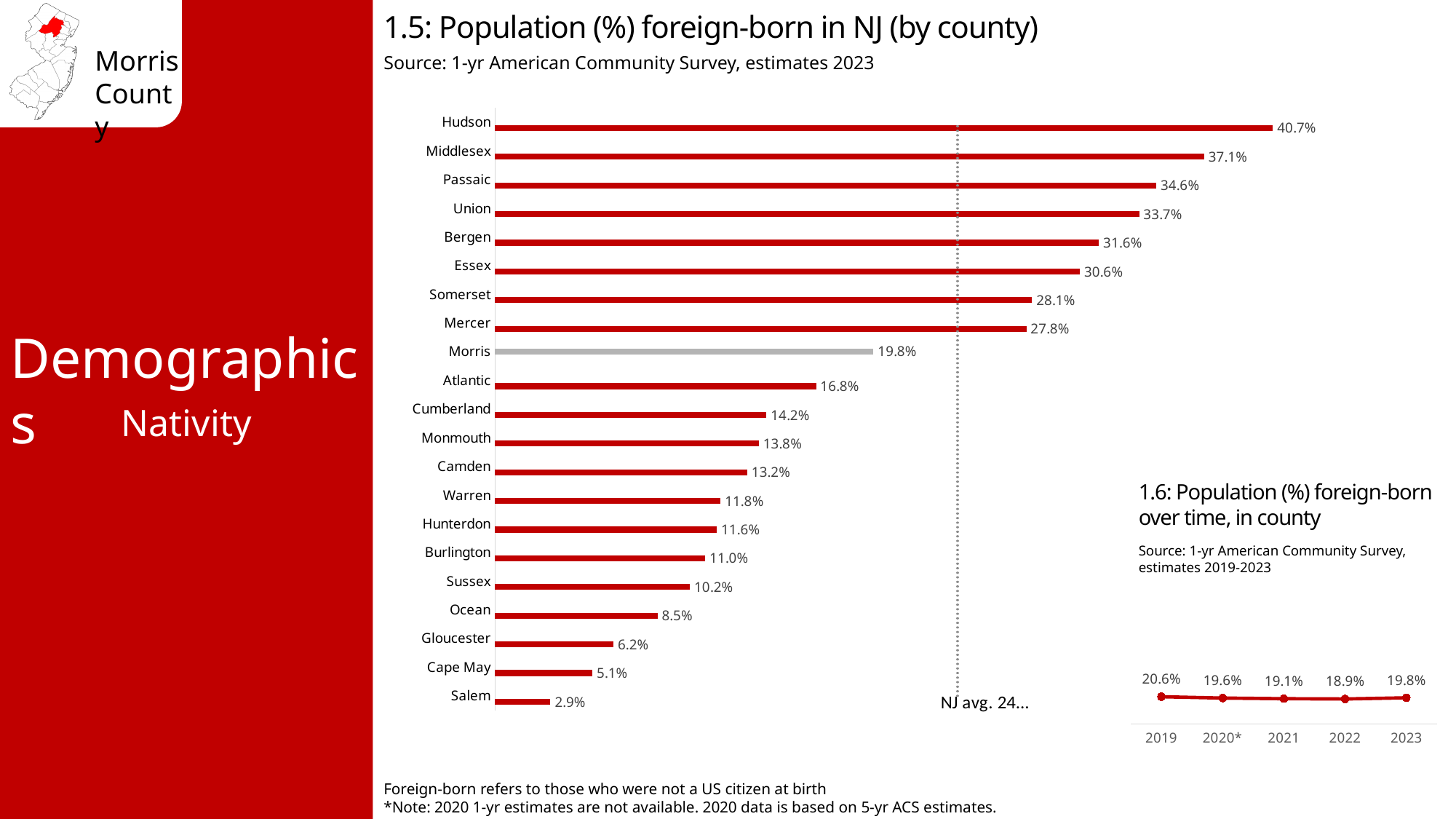
In chart 1.5 (Population (%) foreign-born in NJ by county), how many counties are shown? 21 In chart 1.5 (Population (%) foreign-born in NJ by county), what is the value for Cape May? 5.1% In chart 1.6 (Population (%) foreign-born over time, in county), what is the difference between 2019 and 2022? 1.7% In chart 1.5 (Population (%) foreign-born in NJ by county), what is the value for Morris? 19.8% In chart 1.6 (Population (%) foreign-born over time, in county), what is the value for 2021? 19.1% In chart 1.5 (Population (%) foreign-born in NJ by county), which county has the highest value? Hudson What kind of chart is chart 1.5 (Population (%) foreign-born in NJ by county)? Bar chart In chart 1.5 (Population (%) foreign-born in NJ by county), which county has the lowest value? Salem In chart 1.5 (Population (%) foreign-born in NJ by county), what is the difference between Hudson and Middlesex? 3.6% What kind of chart is chart 1.6 (Population (%) foreign-born over time, in county)? Line chart In chart 1.6 (Population (%) foreign-born over time, in county), which year has the highest value? 2019 In chart 1.5 (Population (%) foreign-born in NJ by county), which is larger, Bergen or Essex? Bergen